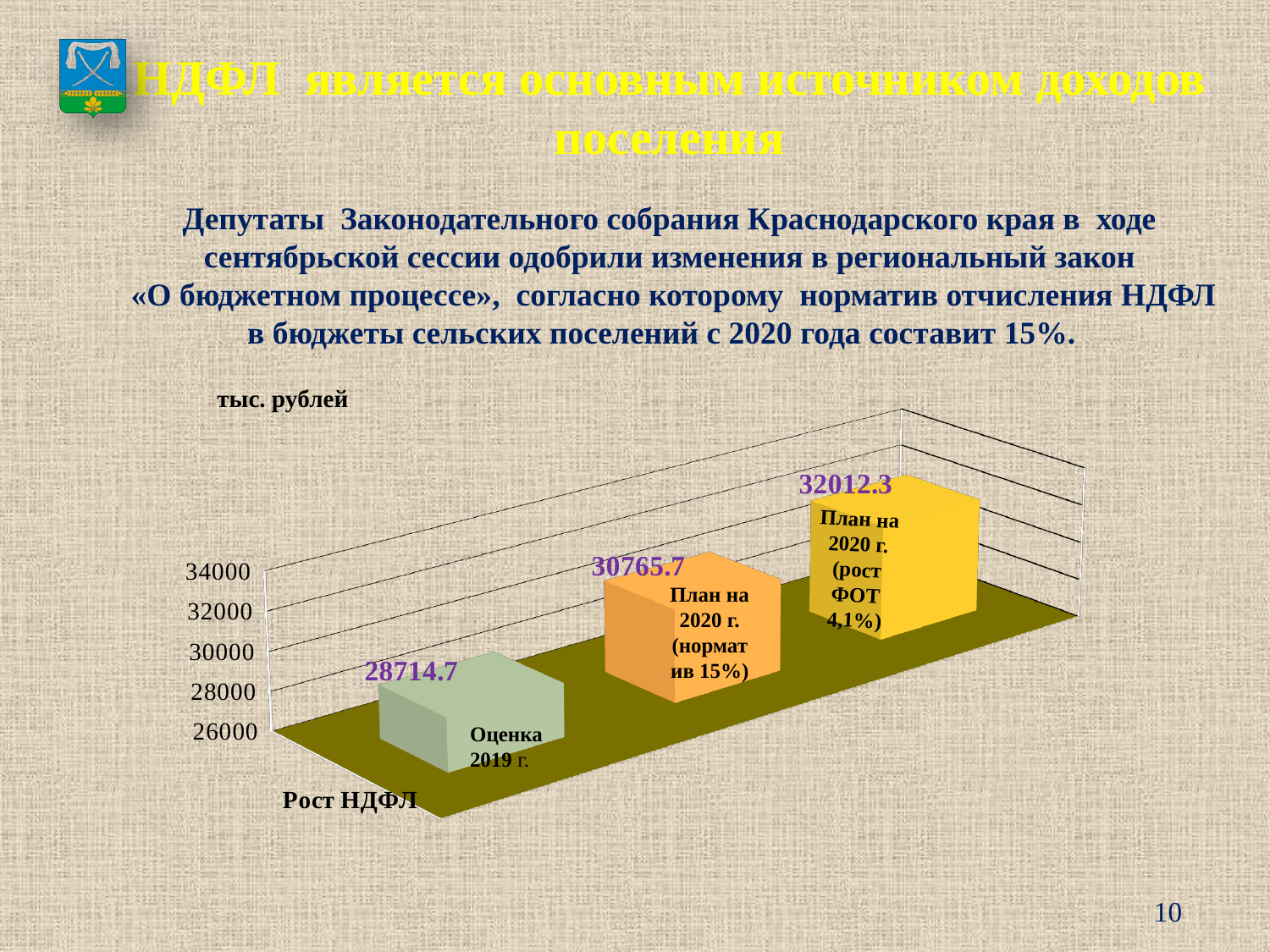
Do the values rise or fall from left to right across the chart? rise What is the value for План на 2020 г. (рост ФОТ 4,1%)? 32012.3 What is the value for Оценка 2019 г.? 28714.7 What is the difference between План на 2020 г. (норматив 15%) and Оценка 2019 г.? 2051.0 Which is larger, the value for Оценка 2019 г. or the value for План на 2020 г. (норматив 15%)? План на 2020 г. (норматив 15%) Is the value for Оценка 2019 г. greater or less than 30000? less How many bars are shown in the chart? 3 What is the value for План на 2020 г. (норматив 15%)? 30765.7 What kind of chart is shown on the slide? bar chart What is the difference between План на 2020 г. (рост ФОТ 4,1%) and План на 2020 г. (норматив 15%)? 1246.6 Which category has the highest value? План на 2020 г. (рост ФОТ 4,1%) Which category has the lowest value? Оценка 2019 г.